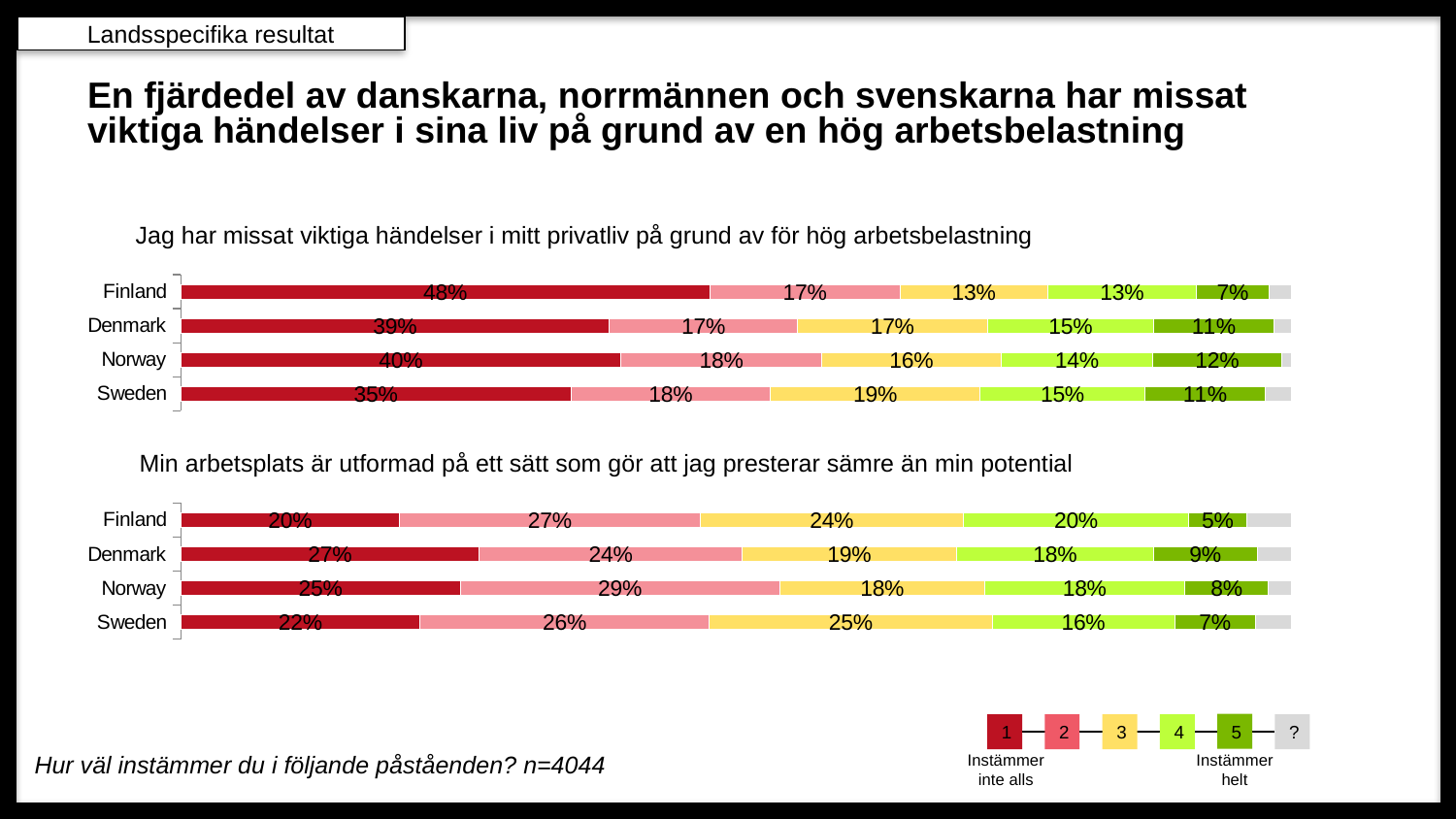
In the top chart, which country has the highest share answering 1 (Instämmer inte alls)? Finland How many entries does the legend at the bottom of the slide list? 6 In the bottom chart, is the share answering 3 larger for Sweden or for Norway? Sweden In the top chart, what percentage of respondents in Norway answered 5 (Instämmer helt)? 12% In the top chart, which country has the lowest share answering 1 (Instämmer inte alls)? Sweden In the bottom chart, which country has the highest share answering 1 (Instämmer inte alls)? Denmark In the bottom chart ("Min arbetsplats är utformad..."), what percentage of respondents in Norway answered 2? 29% In the top chart, what is the difference between Finland's and Sweden's share answering 1 (Instämmer inte alls)? 13 percentage points In the top chart ("Jag har missat viktiga händelser..."), what percentage of respondents in Finland answered 1 (Instämmer inte alls)? 48% In the bottom chart, which country has the lowest share answering 5 (Instämmer helt)? Finland How many countries are shown in each chart? 4 What type of chart is used on this slide? Stacked bar chart